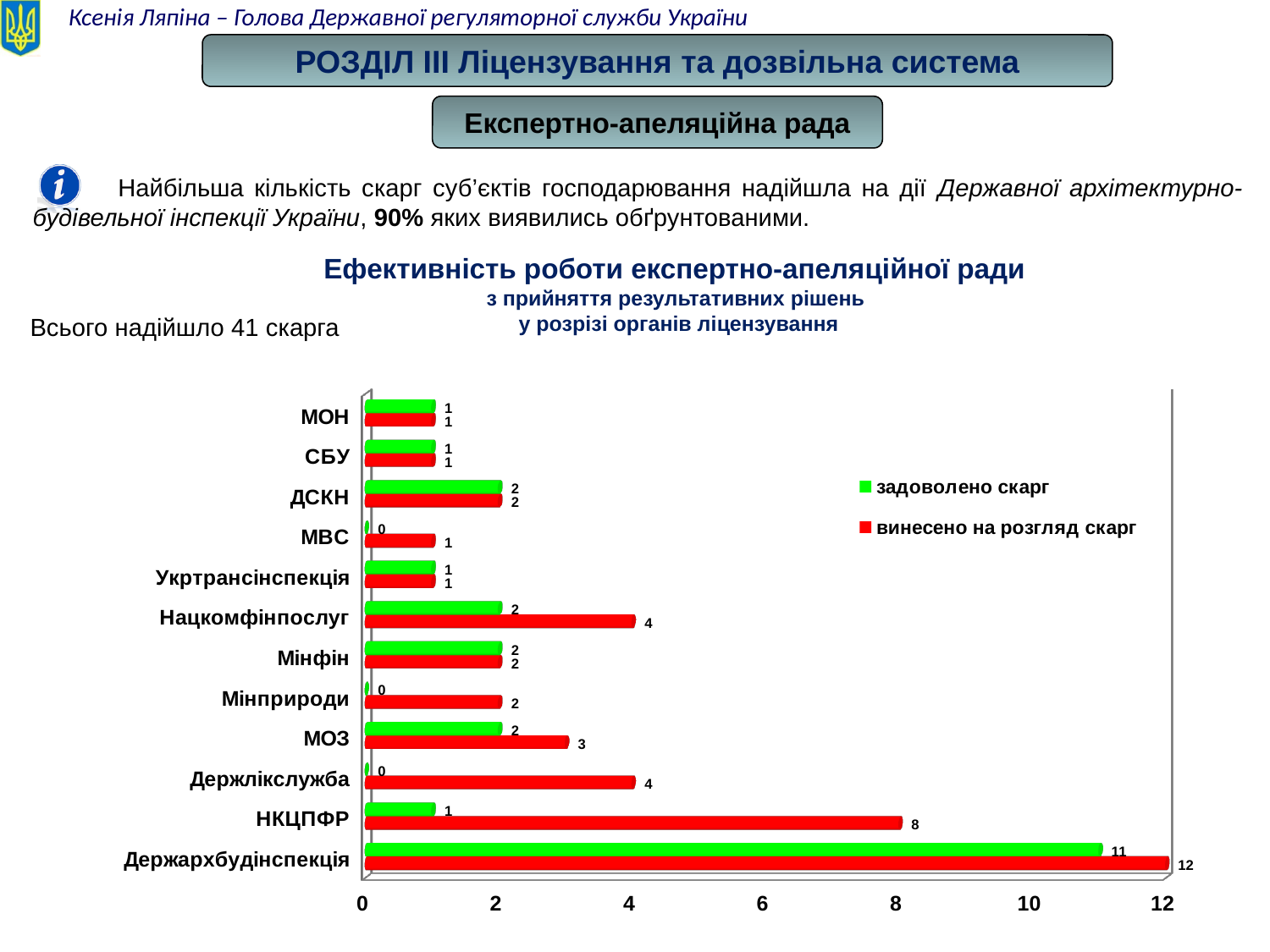
What is the value of "задоволено скарг" for Держлікслужба? 0 What is the difference between "винесено на розгляд скарг" and "задоволено скарг" for НКЦПФР? 7 How many series does the chart legend list? 2 How many licensing bodies (categories) are shown on the chart? 12 Which is larger for МОЗ: "винесено на розгляд скарг" or "задоволено скарг"? винесено на розгляд скарг What is the value of "винесено на розгляд скарг" for Держархбудінспекція? 12 Which category has the highest value of "винесено на розгляд скарг"? Держархбудінспекція What is the value of "винесено на розгляд скарг" for Нацкомфінпослуг? 4 What kind of chart is shown on the slide? bar chart What is the value of "задоволено скарг" for НКЦПФР? 1 What is the difference between "винесено на розгляд скарг" and "задоволено скарг" for Держархбудінспекція? 1 Which colour represents the series "задоволено скарг" in the chart? green